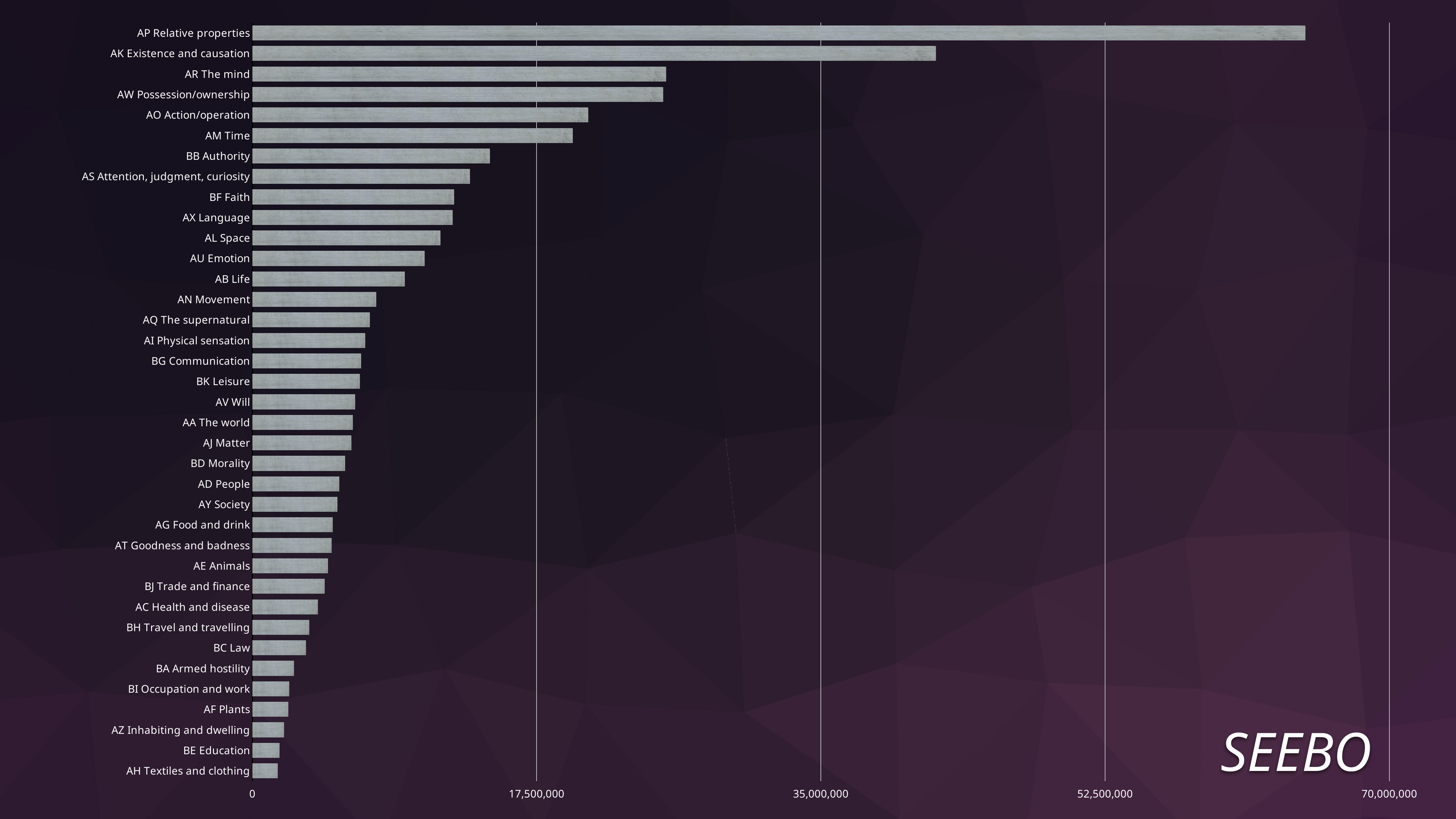
What kind of chart is shown on the slide? bar chart Which category has the highest value? AP Relative properties Is the value for AH Textiles and clothing greater or less than 17,500,000? less Which category has the lowest value? AH Textiles and clothing Is the value for AP Relative properties greater or less than 52,500,000? greater Is the value for AR The mind greater or less than 17,500,000? greater How many categories are plotted in the chart? 37 Which is larger, the value for AB Life or the value for AN Movement? AB Life Which is larger, the value for AP Relative properties or the value for AK Existence and causation? AP Relative properties What is the highest value shown on the horizontal axis? 70,000,000